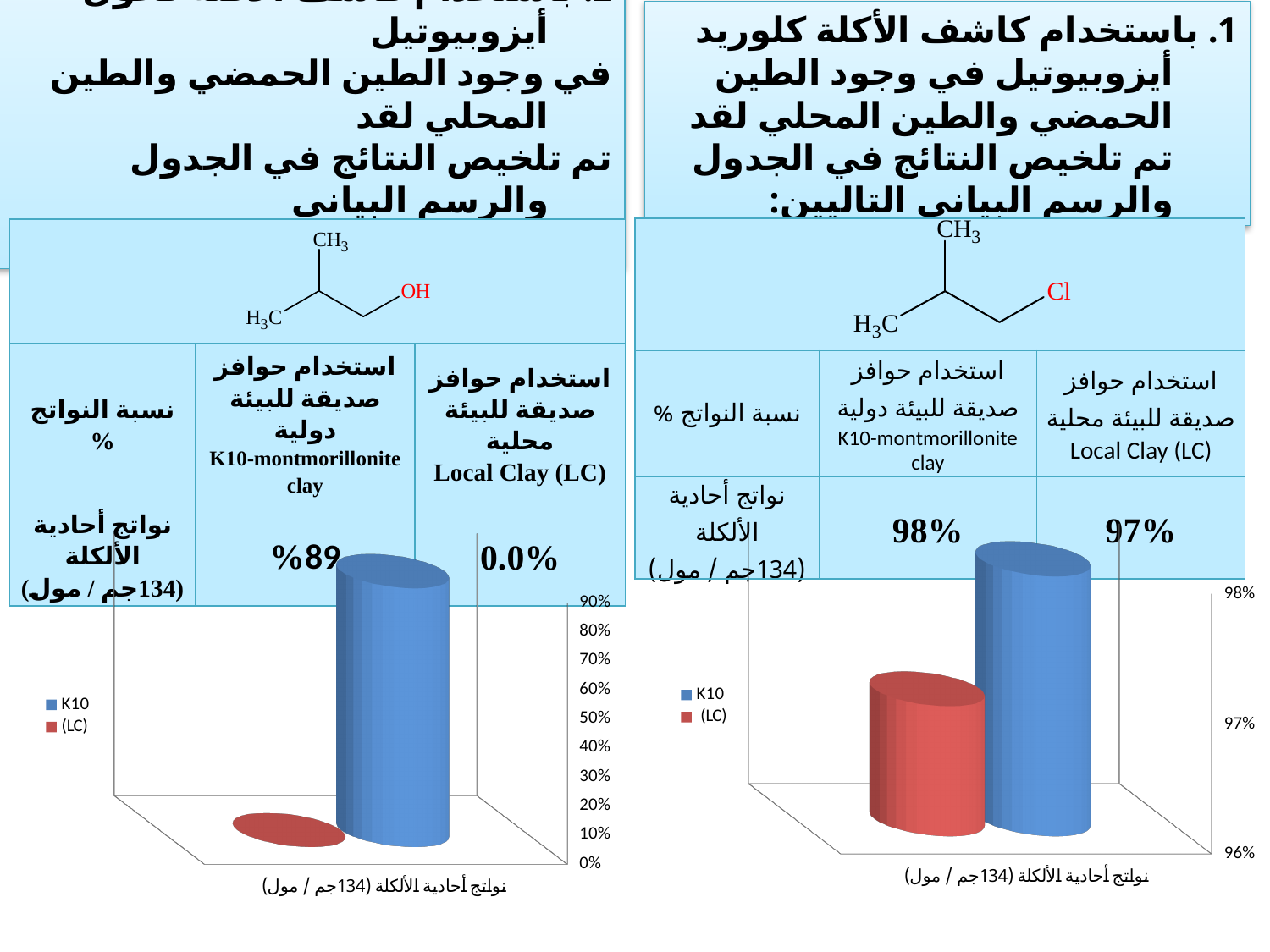
In the left-hand chart, which series has the lower value? (LC) In the left-hand chart, is the value for K10 greater or less than 80%? greater What is the highest value shown on the vertical axis of the left-hand chart? 90% In the left-hand chart, is the value for (LC) greater or less than 10%? less In the right-hand chart, what is the difference between the K10 value and the (LC) value? 1% How many series does the legend of the right-hand chart list? 2 How many series does the legend of the left-hand chart list? 2 In the right-hand chart, which series has the higher value, K10 or (LC)? K10 What colour are the K10 bars in both charts? blue In the right-hand chart, what is the value for (LC)? 97% In the right-hand chart, what is the value for K10? 98% What kind of chart is the chart on the right side of the slide? bar chart